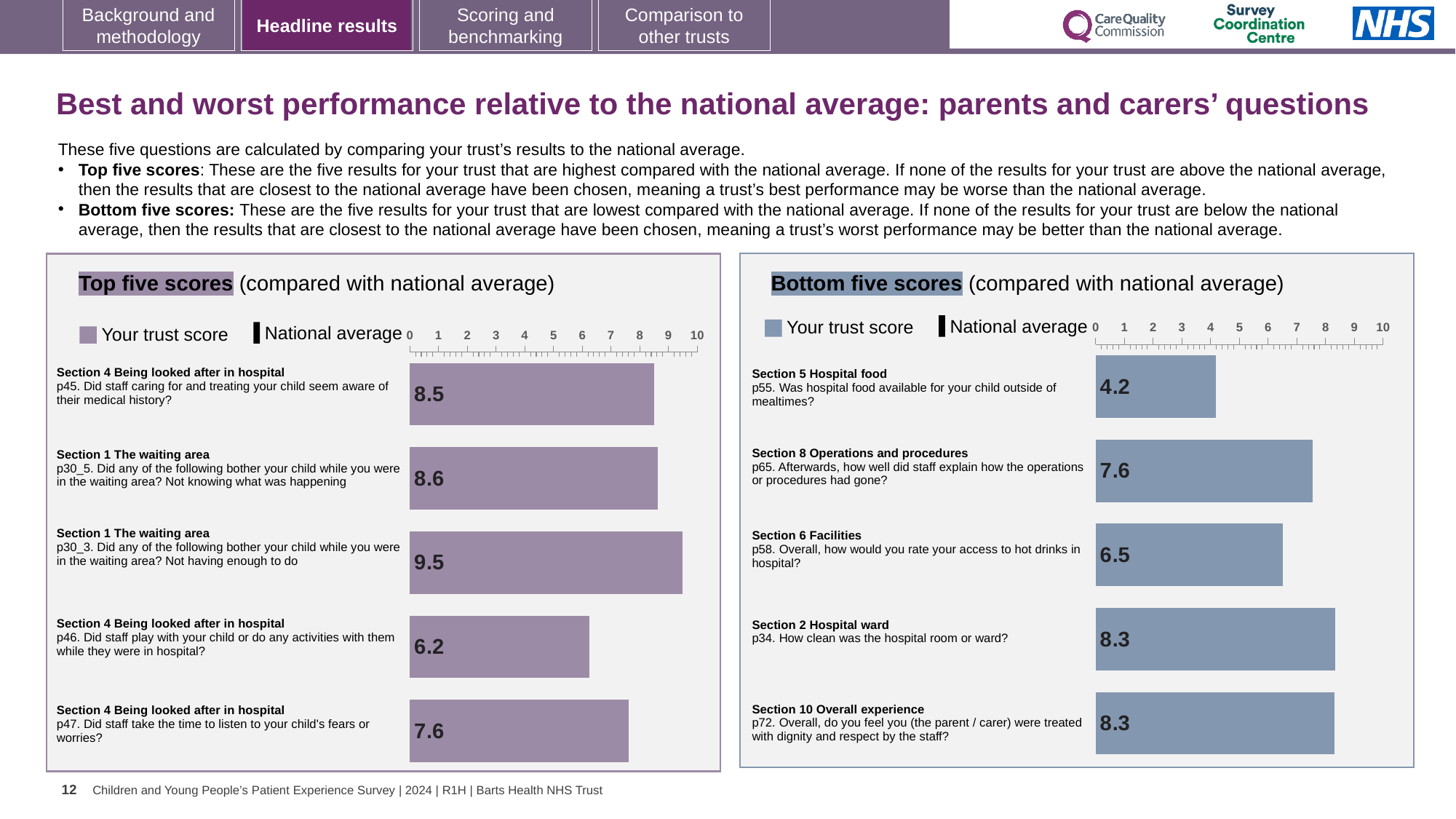
In the Top five scores chart, what is the trust score for p45 (Did staff caring for and treating your child seem aware of their medical history?)? 8.5 How many questions are plotted in the Top five scores chart? 5 In the Bottom five scores chart, what is the trust score for p55 (Was hospital food available for your child outside of mealtimes?)? 4.2 In the Bottom five scores chart, which has the larger trust score: p65 (how well did staff explain how the operations or procedures had gone) or p58 (access to hot drinks in hospital)? p65 How many series does the legend of the Bottom five scores chart list? 2 What kind of chart is the Top five scores chart? Bar chart In the Top five scores chart, which question has the lowest trust score? p46. Did staff play with your child or do any activities with them while they were in hospital? In the Bottom five scores chart, is the trust score for p58 (access to hot drinks in hospital) greater or less than 5? greater In the Top five scores chart, which question has the highest trust score? p30_3. Did any of the following bother your child while you were in the waiting area? Not having enough to do In the Top five scores chart, what is the difference between the trust scores for p30_3 and p46? 3.3 In the Bottom five scores chart, what is the difference between the trust scores for p34 and p55? 4.1 In the Bottom five scores chart, which question has the lowest trust score? p55. Was hospital food available for your child outside of mealtimes?